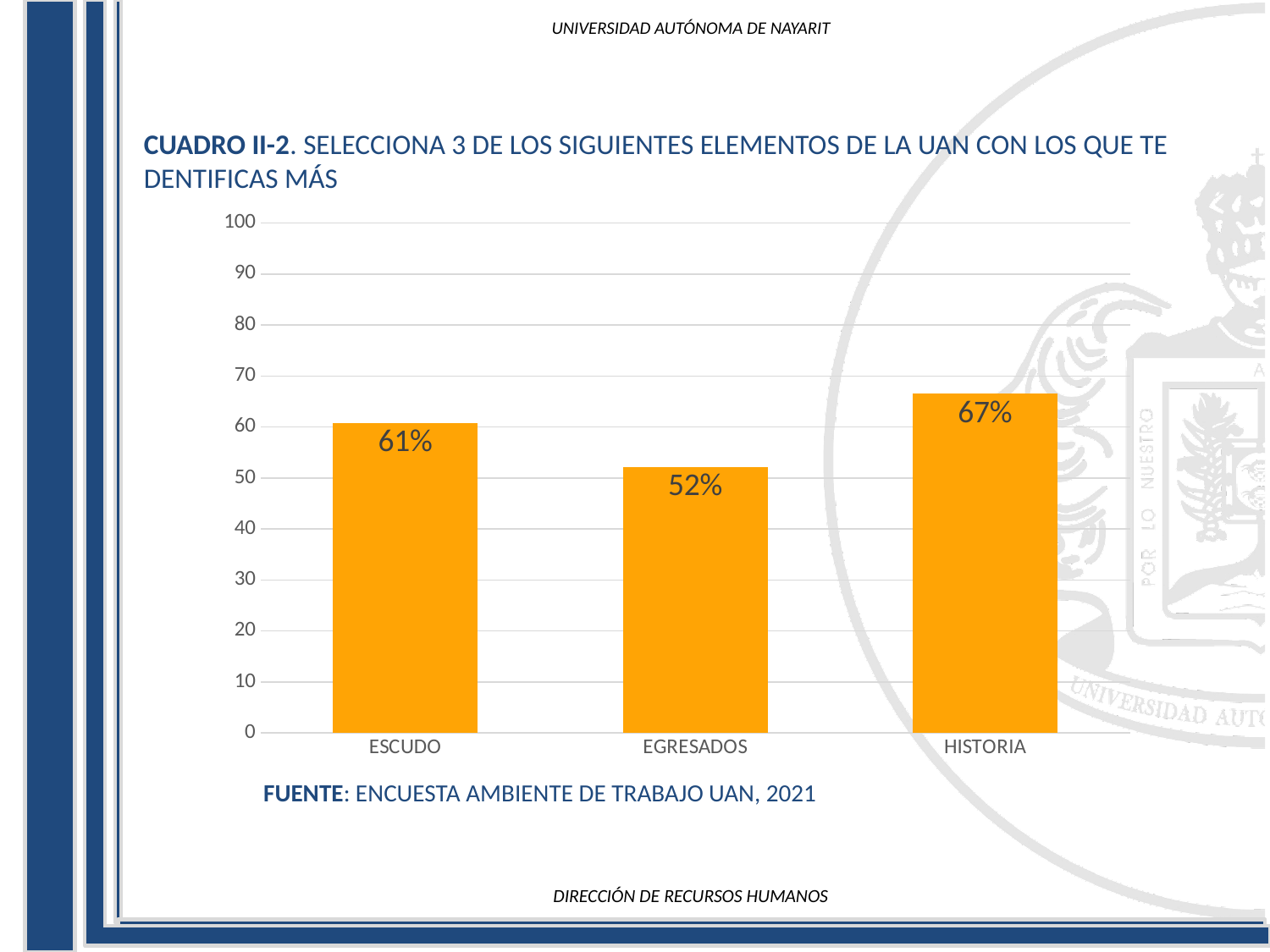
What is the value for HISTORIA? 67% What is the value for ESCUDO? 61% What source is cited below the chart? ENCUESTA AMBIENTE DE TRABAJO UAN, 2021 How many categories are shown on the x axis? 3 Which category has the lowest value? EGRESADOS What kind of chart is shown on the slide? bar chart Which category has the highest value? HISTORIA What is the difference between the values for ESCUDO and EGRESADOS? 9% What is the value for EGRESADOS? 52% Is the value for EGRESADOS greater or less than 60? less What is the difference between the values for HISTORIA and EGRESADOS? 15% Which is larger, the value for ESCUDO or the value for HISTORIA? HISTORIA